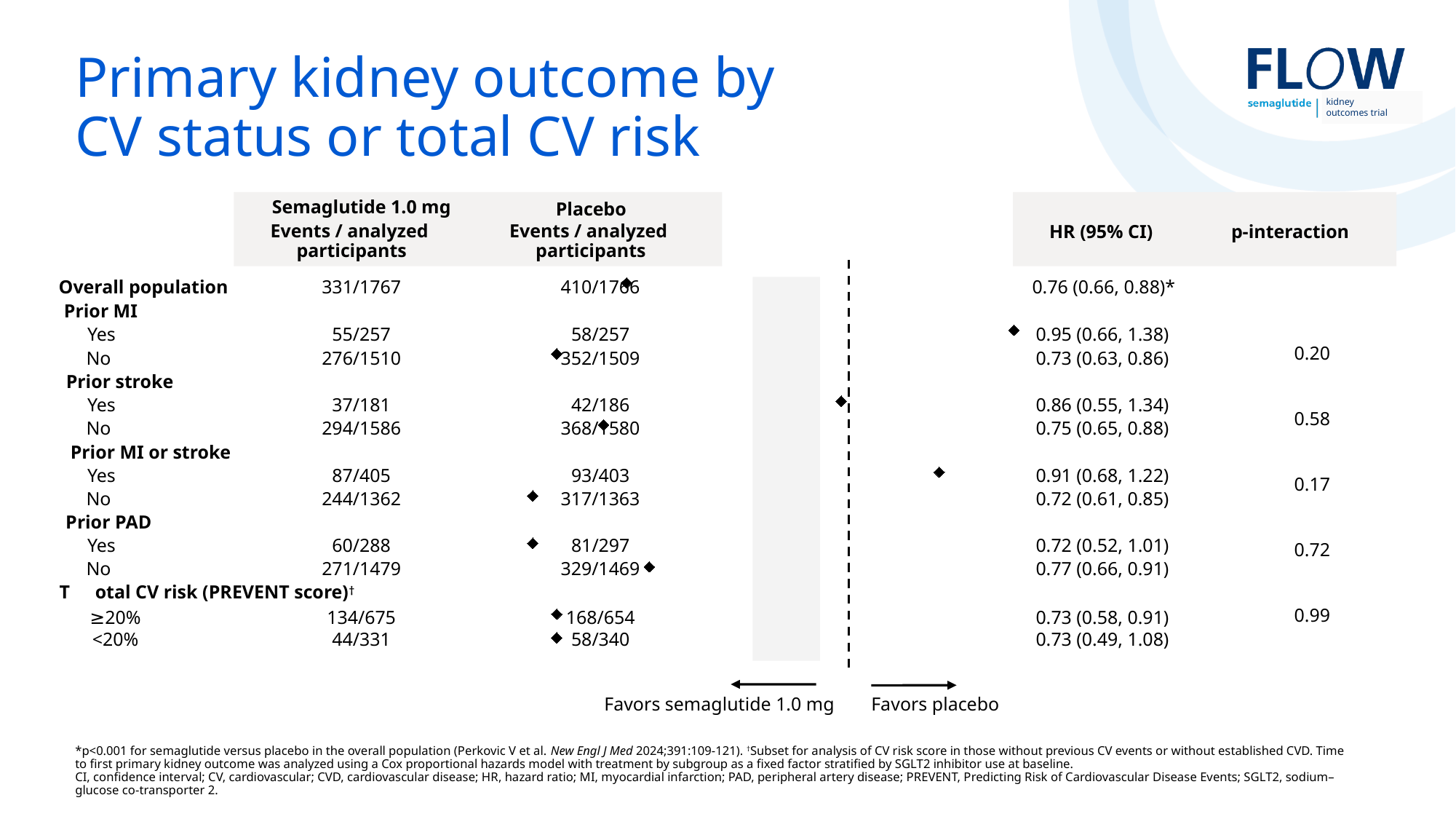
What is the HR (95% CI) for the overall population? 0.76 (0.66, 0.88)* What kind of chart is shown on the slide? Forest plot Which subgroup has the highest hazard ratio? Prior MI, Yes Which subgroup has the lowest p-interaction value? Prior MI or stroke What are the events / analyzed participants for semaglutide 1.0 mg in the prior PAD Yes subgroup? 60/288 What does the arrow pointing left below the plot indicate? Favors semaglutide 1.0 mg What is the p-interaction value for the prior stroke subgroup? 0.58 What are the events / analyzed participants for placebo in the total CV risk ≥20% subgroup? 168/654 Which subgroup has the highest p-interaction value? Total CV risk (PREVENT score) Is the hazard ratio larger for prior stroke Yes or prior stroke No? Prior stroke Yes What is the difference between the hazard ratios for prior MI Yes and prior MI No? 0.22 What is the HR (95% CI) for participants with prior MI (Yes)? 0.95 (0.66, 1.38)